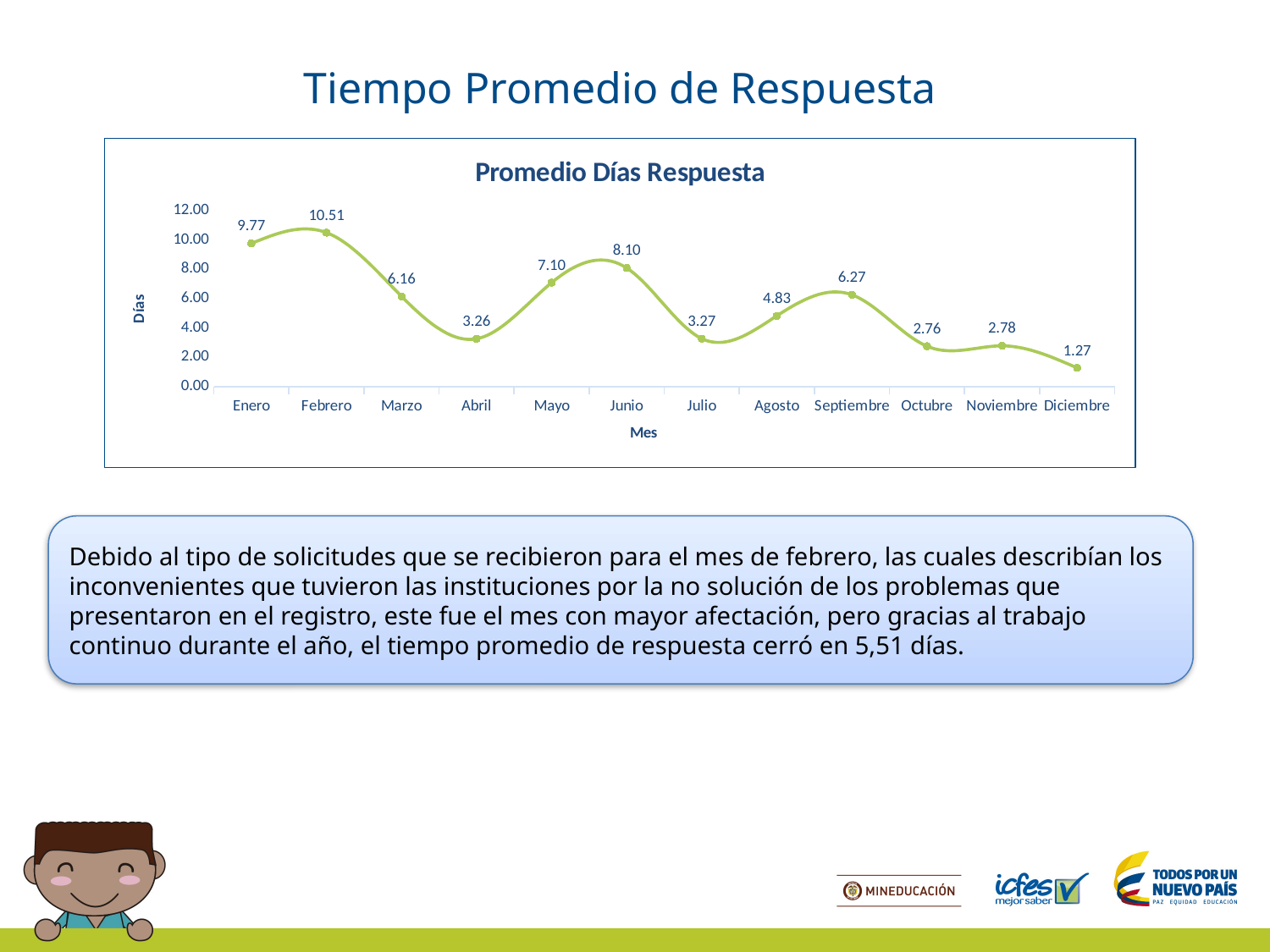
What is the value for Febrero? 10.51 What is the value for Diciembre? 1.27 What kind of chart is shown? line chart Which is larger, the value for Mayo or the value for Junio? Junio What is the difference between the values for Febrero and Marzo? 4.35 Is the value for Agosto greater or less than 4.00? greater Which month has the highest value? Febrero Do the values generally rise or fall from Septiembre to Diciembre? fall What is the title of the chart? Promedio Días Respuesta What is the value for Septiembre? 6.27 How many months are plotted on the chart? 12 Which month has the lowest value? Diciembre